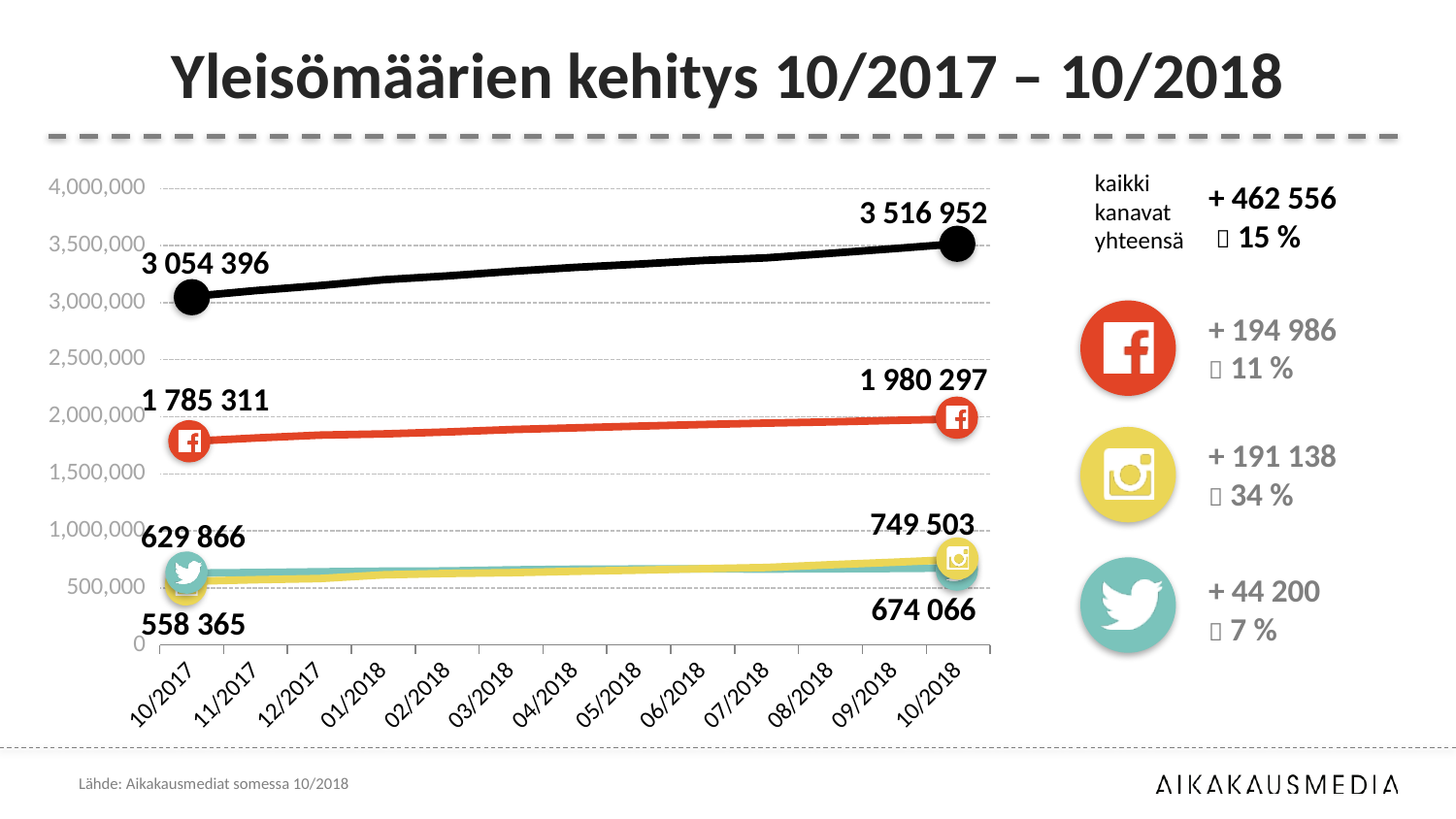
How many months are shown on the x axis? 13 Which line has the highest value at 10/2018? the black (total) line What is the value of the Instagram line at 10/2018? 749 503 What is the value of the Twitter line at 10/2017? 629 866 What type of chart is shown on the slide? line chart What is the value of the black (total) line at 10/2017? 3 054 396 What is the value of the Facebook line at 10/2018? 1 980 297 What is the value of the black (total) line at 10/2018? 3 516 952 By how much did the Facebook line increase from 10/2017 to 10/2018? 194 986 What is the value of the Facebook line at 10/2017? 1 785 311 Does the black (total) line rise or fall from 10/2017 to 10/2018? rise Which line has the lowest value at 10/2017? Instagram